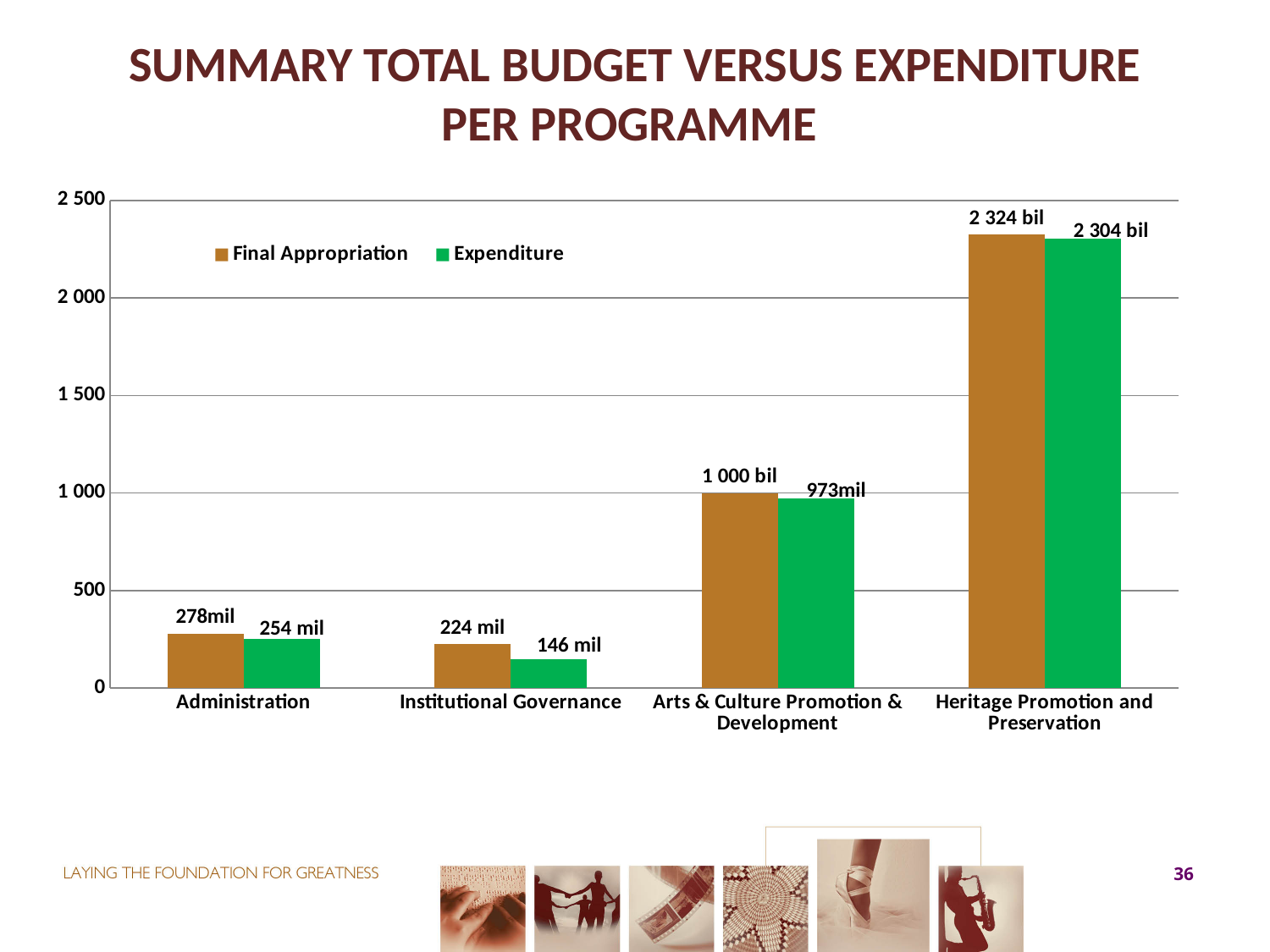
What is the Final Appropriation value for Administration? 278mil Which programme has the highest Final Appropriation? Heritage Promotion and Preservation How many series does the legend list? 2 What is the difference between Final Appropriation and Expenditure for Institutional Governance? 78 mil How many programmes are shown on the x axis? 4 Which programme has the lowest Expenditure? Institutional Governance What is the Expenditure value for Heritage Promotion and Preservation? 2 304 bil What kind of chart is shown on the slide? Bar chart What is the Final Appropriation value for Arts & Culture Promotion & Development? 1 000 bil What is the difference between Final Appropriation and Expenditure for Heritage Promotion and Preservation? 20 bil Which is larger for Administration: Final Appropriation or Expenditure? Final Appropriation What is the Expenditure value for Institutional Governance? 146 mil